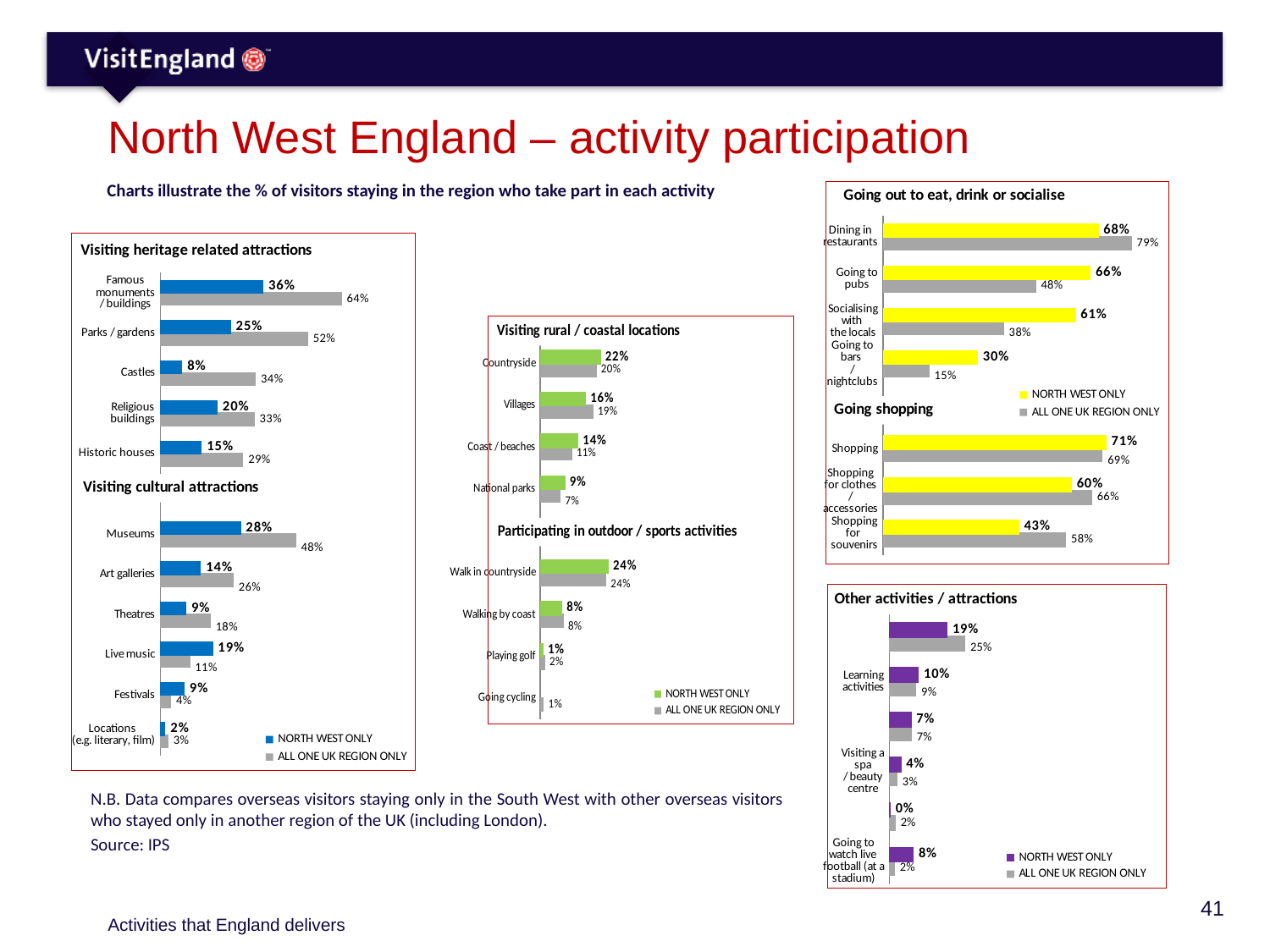
In the 'Other activities / attractions' chart, what is the NORTH WEST ONLY value for Going to watch live football (at a stadium)? 8% What type of chart is the 'Visiting heritage related attractions' chart? Bar chart In the 'Visiting heritage related attractions' chart, what is the ALL ONE UK REGION ONLY value for Famous monuments / buildings? 64% In the 'Going out to eat, drink or socialise' chart, which category has the lowest NORTH WEST ONLY value? Going to bars / nightclubs In the 'Going shopping' chart, what is the difference between the ALL ONE UK REGION ONLY and NORTH WEST ONLY values for Shopping for souvenirs? 15% In the 'Visiting cultural attractions' chart, which category has the highest NORTH WEST ONLY value? Museums In the 'Going out to eat, drink or socialise' chart, what is the ALL ONE UK REGION ONLY value for Dining in restaurants? 79% In the 'Visiting cultural attractions' chart, what is the difference between the NORTH WEST ONLY and ALL ONE UK REGION ONLY values for Live music? 8% How many categories are shown in the 'Going shopping' chart? 3 In the 'Visiting heritage related attractions' chart, what is the NORTH WEST ONLY value for Castles? 8% In the 'Participating in outdoor / sports activities' chart, what is the NORTH WEST ONLY value for Walk in countryside? 24% In the 'Visiting rural / coastal locations' chart, which is larger for Villages: the NORTH WEST ONLY value or the ALL ONE UK REGION ONLY value? ALL ONE UK REGION ONLY